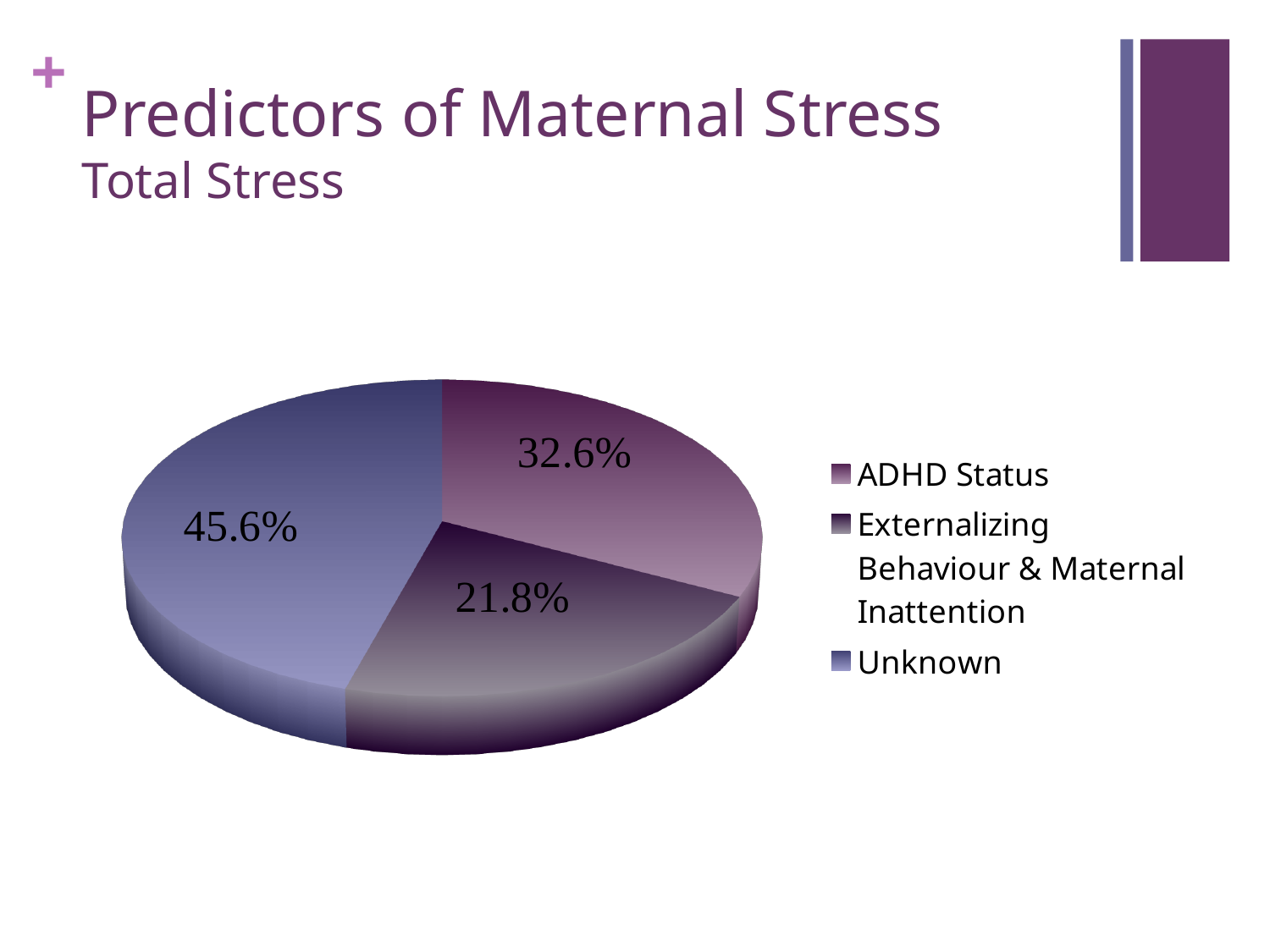
What share of the pie does Unknown account for? 45.6% What is the subtitle shown under the slide title? Total Stress How many entries does the legend list? 3 Which is larger, the slice for ADHD Status or the slice for Unknown? Unknown What kind of chart is shown on the slide? pie chart What is the difference in percentage points between the Unknown slice and the ADHD Status slice? 13.0 percentage points What share of the pie does ADHD Status account for? 32.6% What share of the pie does Externalizing Behaviour & Maternal Inattention account for? 21.8% Which category has the smallest slice of the pie? Externalizing Behaviour & Maternal Inattention What is the difference in percentage points between the ADHD Status slice and the Externalizing Behaviour & Maternal Inattention slice? 10.8 percentage points Which category has the largest slice of the pie? Unknown How many slices does the pie chart have? 3